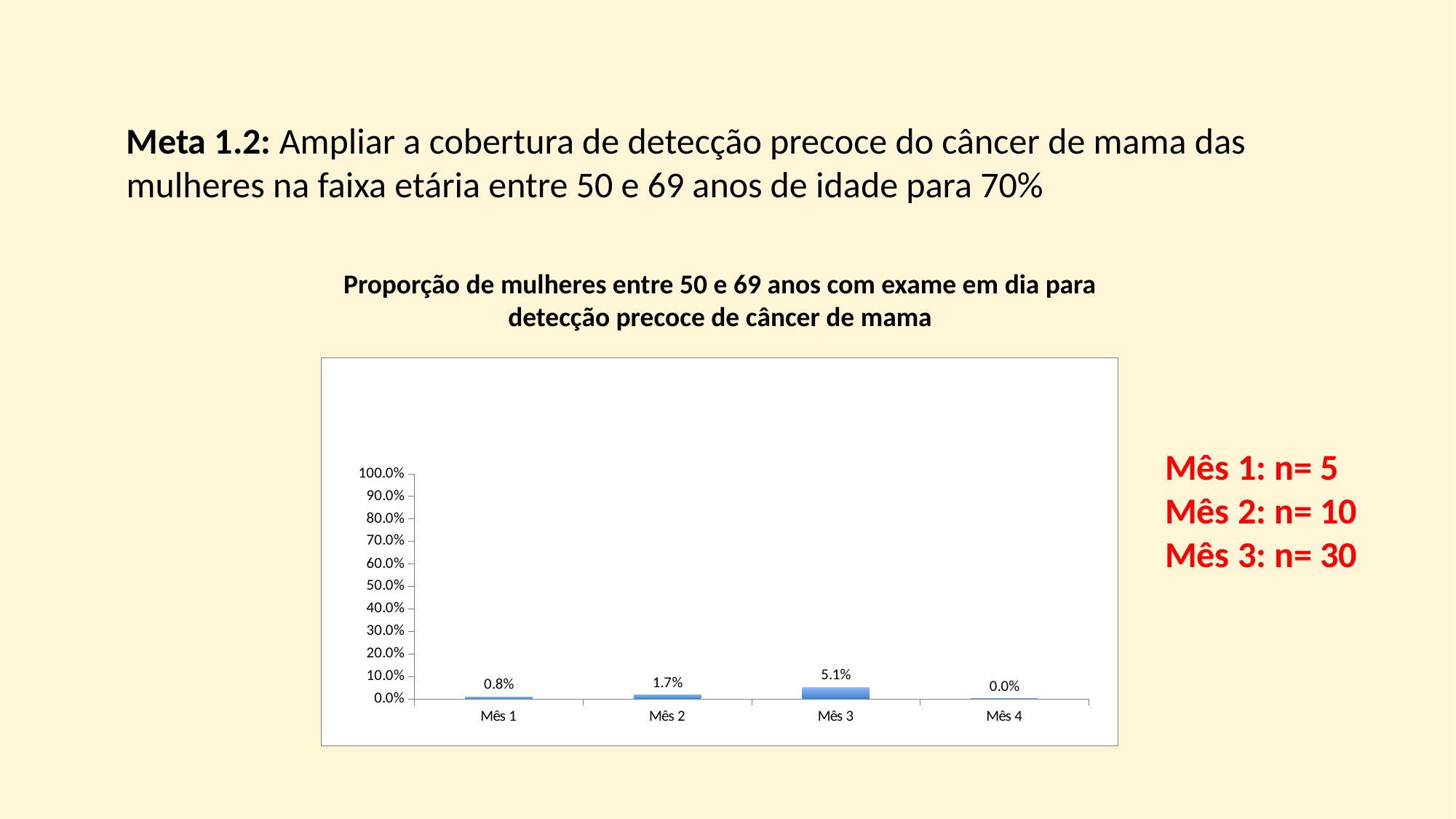
What is the difference between the values for Mês 3 and Mês 2? 3.4% Which is larger, the value for Mês 1 or the value for Mês 2? Mês 2 What is the title of the chart? Proporção de mulheres entre 50 e 69 anos com exame em dia para detecção precoce de câncer de mama What kind of chart is shown? bar chart Which month has the lowest value? Mês 4 Is the value for Mês 3 greater or less than 10.0%? less How many months are shown on the x axis? 4 Which month has the highest value? Mês 3 What is the value for Mês 4? 0.0% What is the value for Mês 2? 1.7% What is the value for Mês 1? 0.8% What is the value for Mês 3? 5.1%